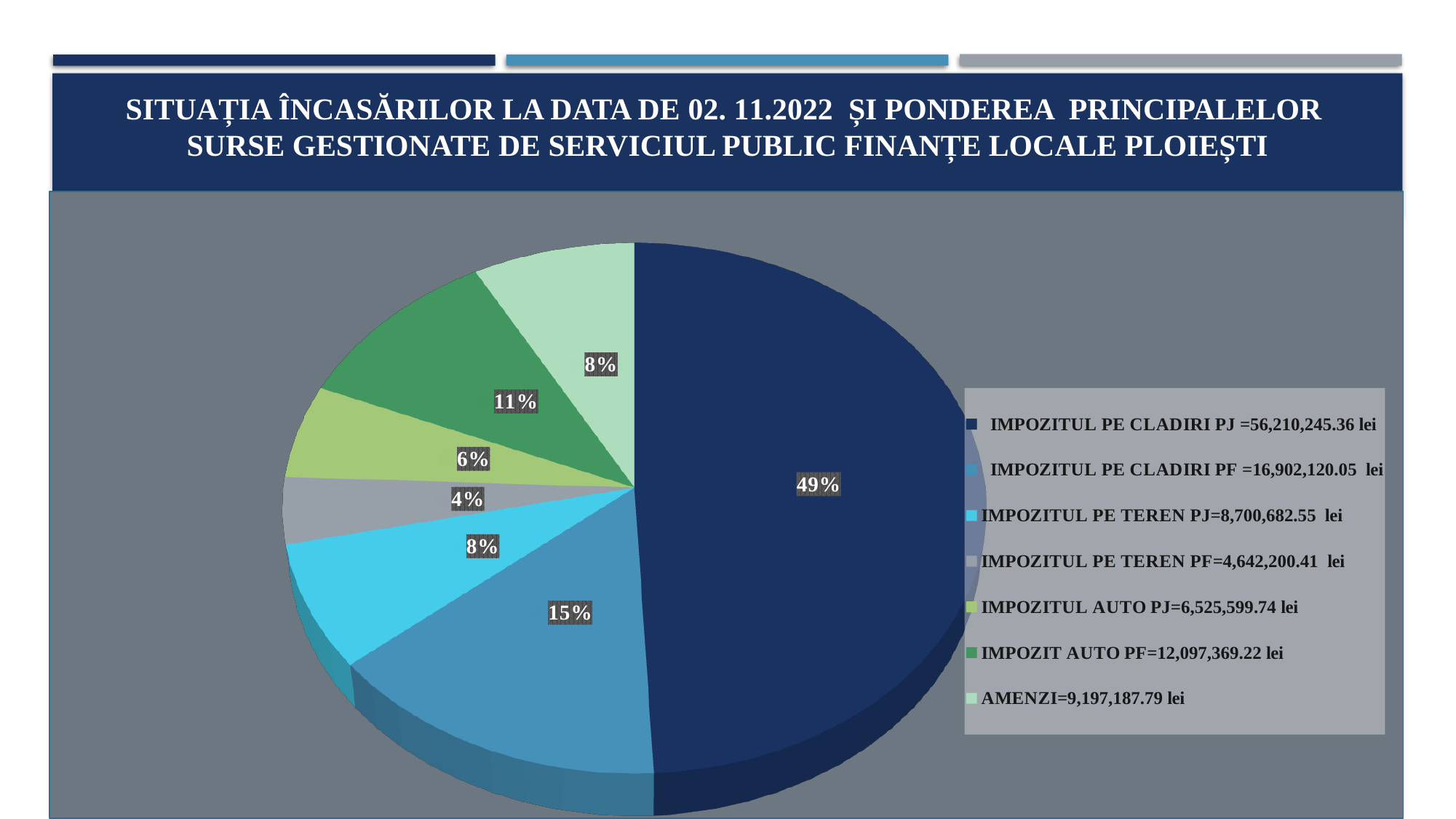
What is the difference in percentage points between the share for IMPOZITUL PE CLADIRI PJ and the share for IMPOZITUL PE CLADIRI PF? 34 percentage points Which category has the smallest slice of the pie? IMPOZITUL PE TEREN PF How many slices does the pie chart have? 7 What value in lei does the legend give for AMENZI? 9,197,187.79 lei Which category has the largest slice of the pie? IMPOZITUL PE CLADIRI PJ What kind of chart is shown on the slide? pie chart What share of the pie does IMPOZIT AUTO PF represent? 11% What share of the pie does IMPOZITUL PE CLADIRI PF represent? 15% Which is larger, the share for IMPOZIT AUTO PF or the share for IMPOZITUL AUTO PJ? IMPOZIT AUTO PF What share of the pie does IMPOZITUL PE CLADIRI PJ represent? 49% What value in lei does the legend give for IMPOZITUL PE TEREN PJ? 8,700,682.55 lei